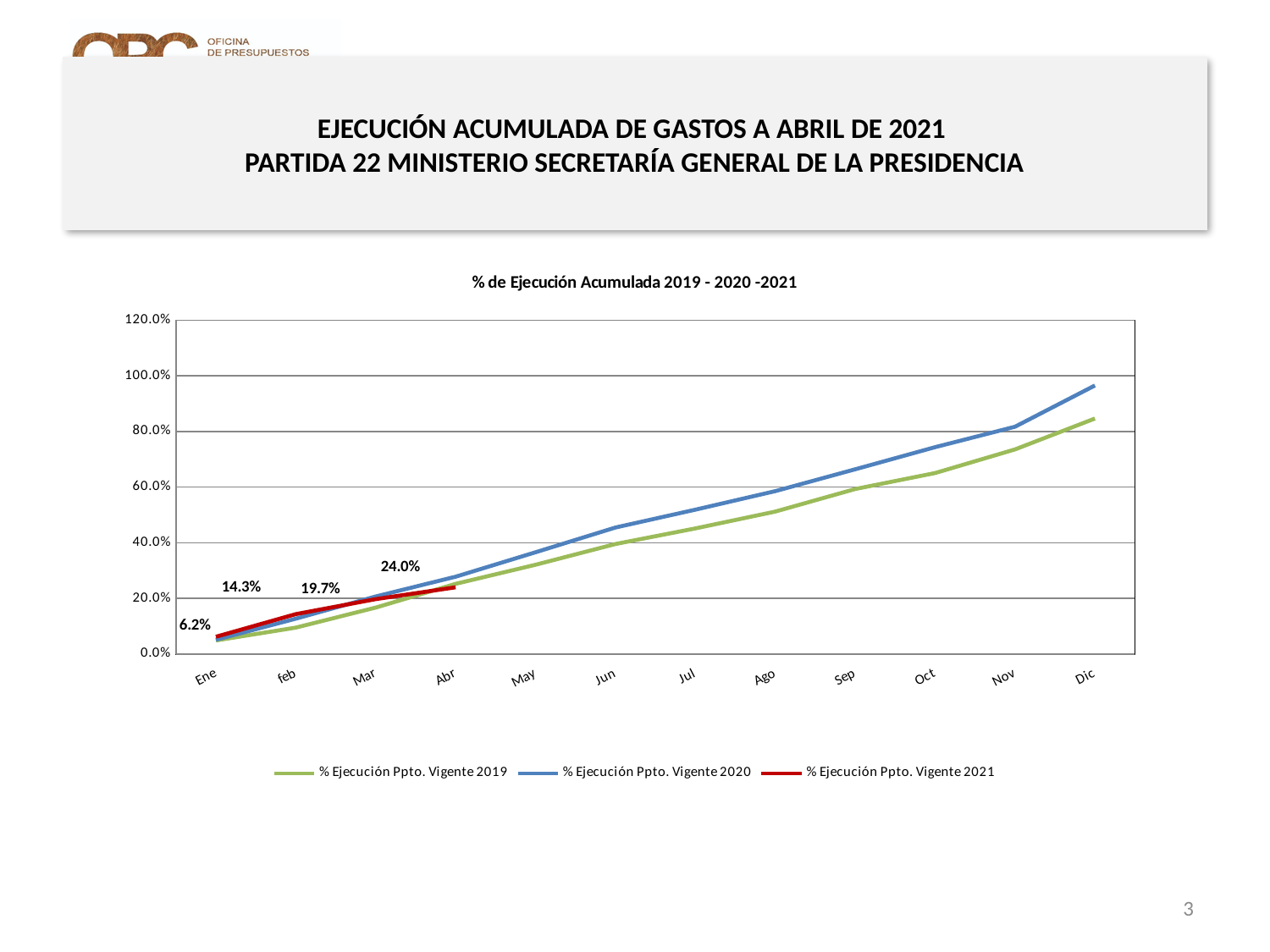
What is the value of % Ejecución Ppto. Vigente 2021 in Ene? 6.2% Do the values of % Ejecución Ppto. Vigente 2020 rise or fall from Ene to Dic? Rise Is the value of % Ejecución Ppto. Vigente 2020 in Dic greater or less than 80.0%? greater What is the difference between the % Ejecución Ppto. Vigente 2021 values for Abr and Ene? 17.8% What is the value of % Ejecución Ppto. Vigente 2021 in Abr? 24.0% How many months are shown on the x axis? 12 What is the value of % Ejecución Ppto. Vigente 2021 in Mar? 19.7% How many series does the legend list? 3 What is the value of % Ejecución Ppto. Vigente 2021 in feb? 14.3% What kind of chart is shown on the slide? Line chart Which series has the higher value in Dic, % Ejecución Ppto. Vigente 2019 or % Ejecución Ppto. Vigente 2020? % Ejecución Ppto. Vigente 2020 What is the difference between the % Ejecución Ppto. Vigente 2021 values for feb and Ene? 8.1%